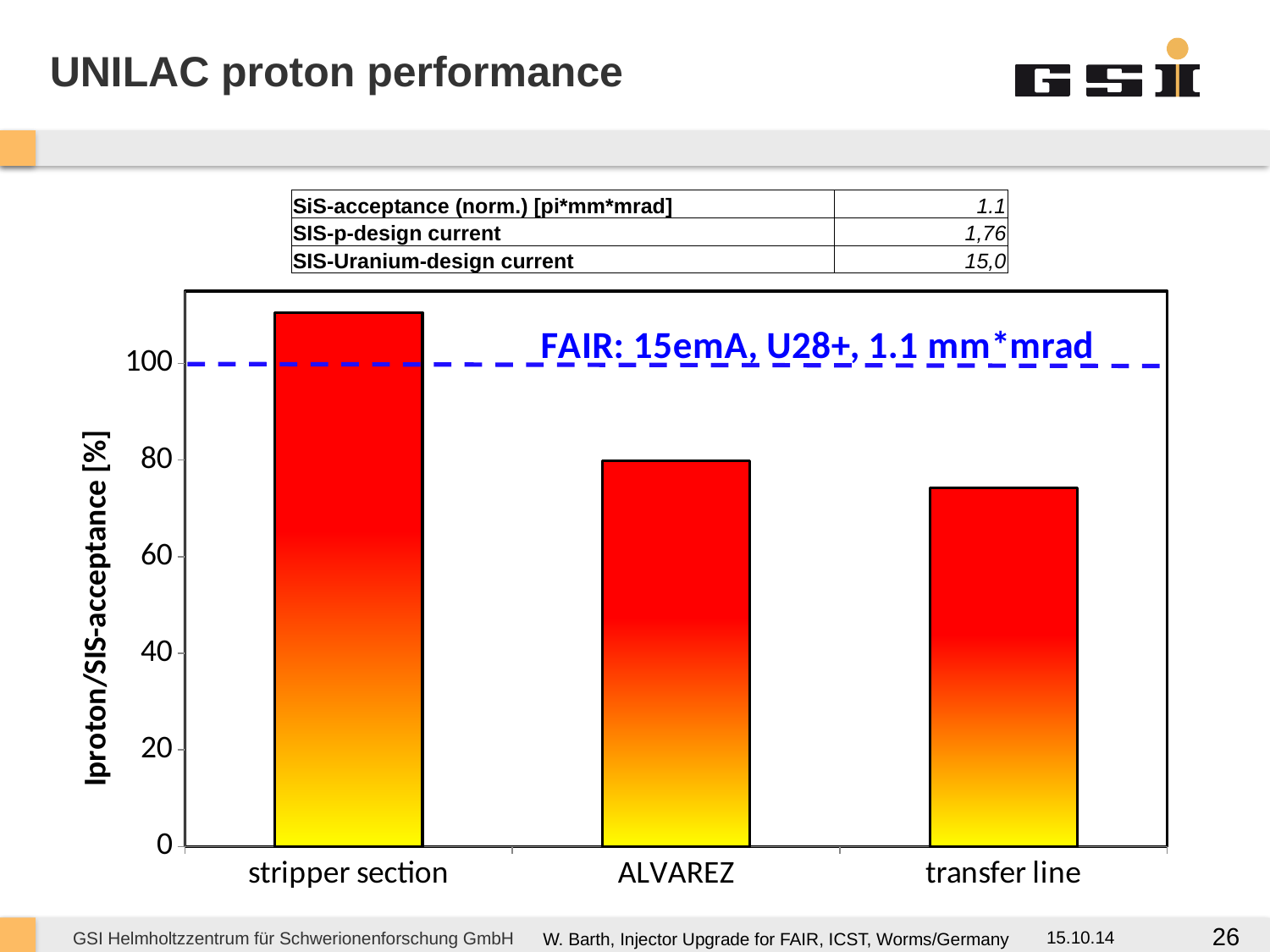
What is the label of the y axis of the chart? Iproton/SIS-acceptance [%] Is the value for transfer line greater or less than 80? less What kind of chart is shown on the slide? bar chart Which category has the highest value in the chart? stripper section How many categories are shown on the x axis of the chart? 3 Which has a larger value, ALVAREZ or transfer line? ALVAREZ Is the value for ALVAREZ greater or less than 60? greater What text labels the dashed horizontal line at 100 in the chart? FAIR: 15emA, U28+, 1.1 mm*mrad Do the bar values rise or fall from left to right along the x axis? fall Is the value for stripper section greater or less than 100? greater Which has a larger value, stripper section or ALVAREZ? stripper section Which category has the lowest value in the chart? transfer line